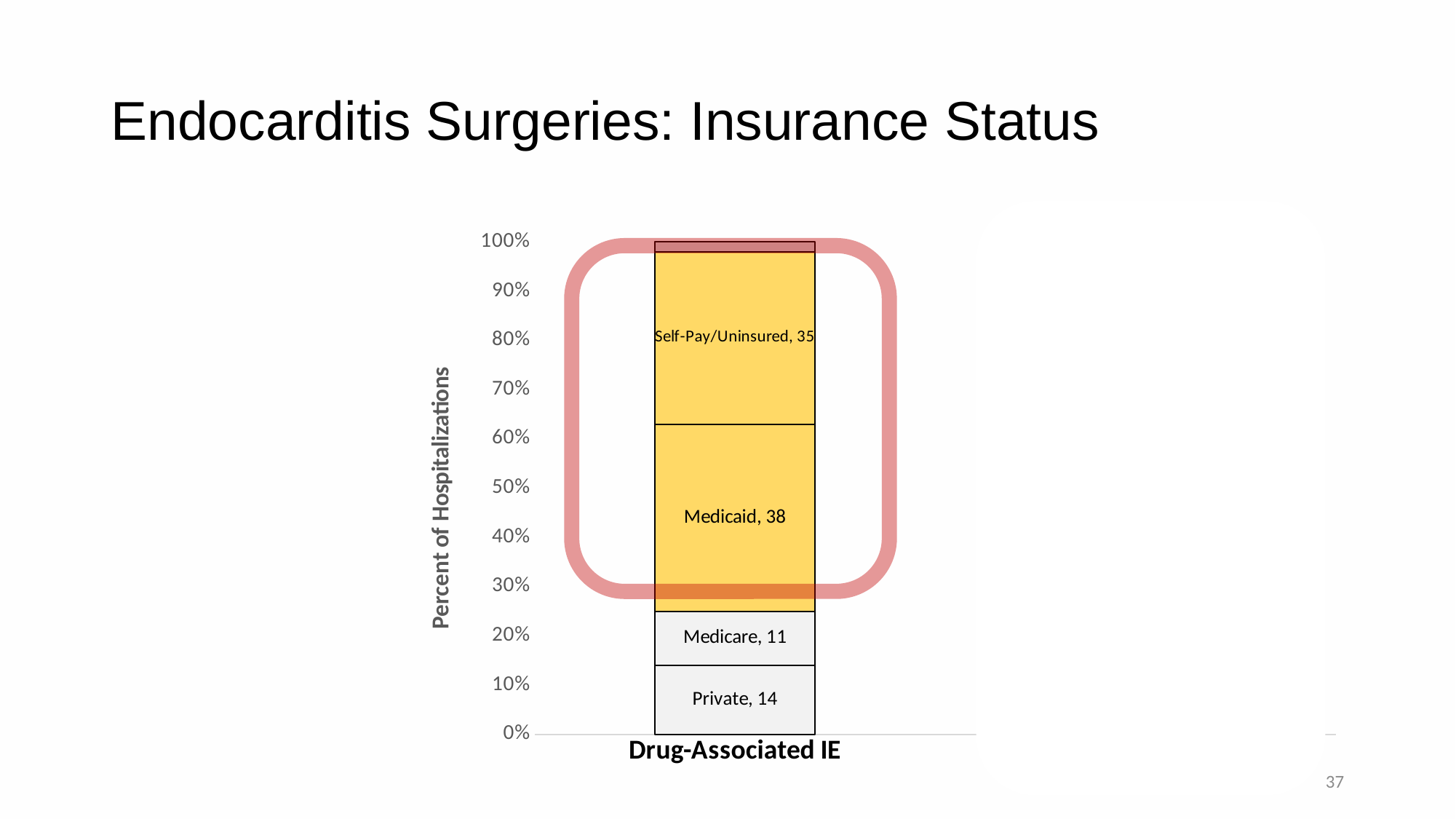
What is the label of the y axis? Percent of Hospitalizations How many categories are shown on the x axis? 1 Which is larger, the Private value or the Medicare value? Private Which labeled insurance segment has the highest value? Medicaid What is the value for Self-Pay/Uninsured in the Drug-Associated IE bar? 35 What is the difference between the Medicaid and Self-Pay/Uninsured values? 3 What is the difference between the Medicaid and Medicare values? 27 What is the value for Medicare in the Drug-Associated IE bar? 11 Which of the labeled insurance segments has the lowest value? Medicare What is the value for Private in the Drug-Associated IE bar? 14 What is the value for Medicaid in the Drug-Associated IE bar? 38 What kind of chart is shown on the slide? Stacked bar chart